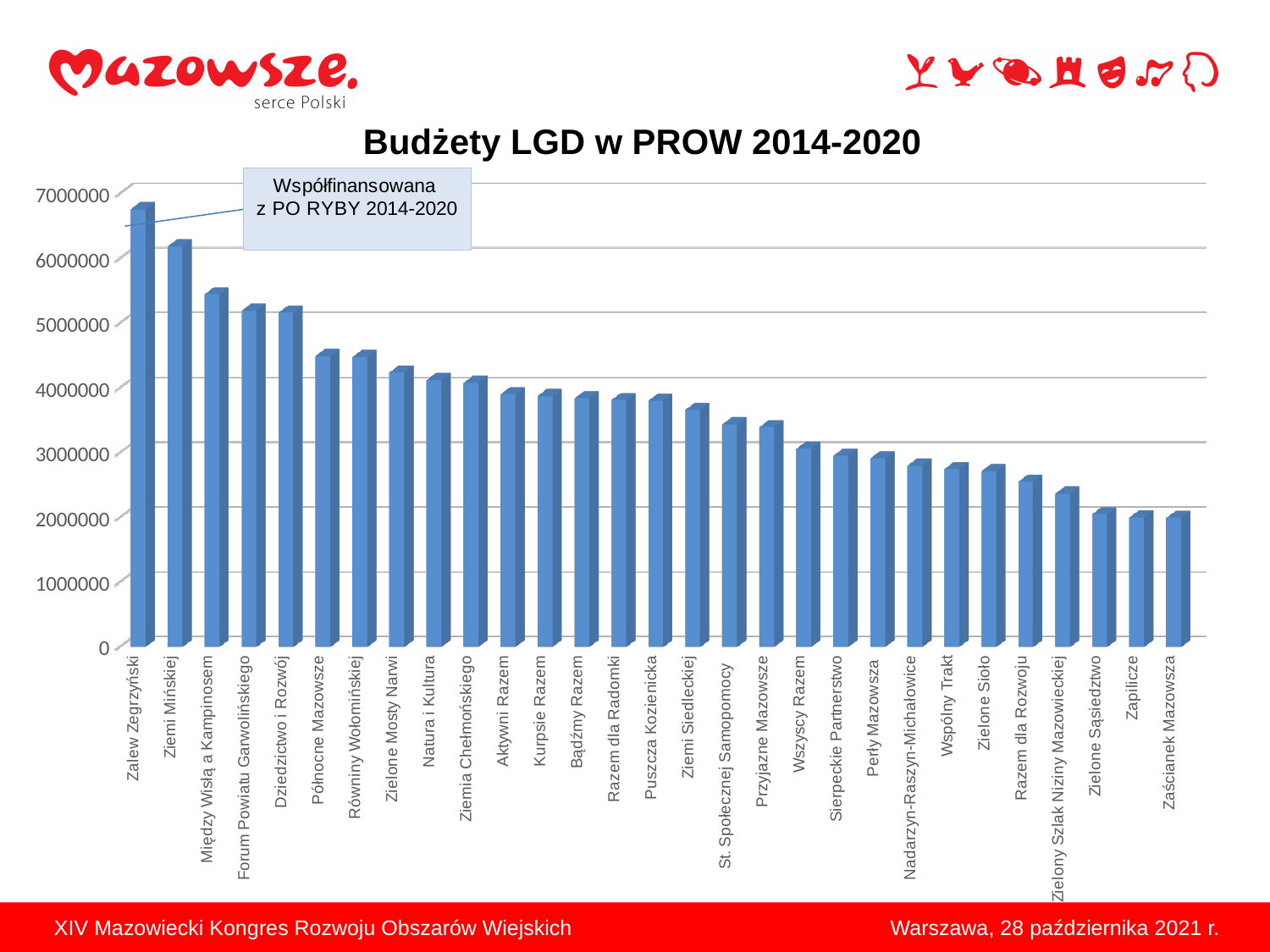
Is the value for Północne Mazowsze greater or less than 4000000? greater Is the value for Między Wisłą a Kampinosem greater or less than 5000000? greater Is the value for Przyjazne Mazowsze greater or less than 4000000? less How many LGD categories are plotted on the x axis? 29 Do the values rise or fall moving from left to right along the x axis? fall What kind of chart is shown on the slide? bar chart What is the title of the chart? Budżety LGD w PROW 2014-2020 Which has the larger budget, Zalew Zegrzyński or Ziemi Mińskiej? Zalew Zegrzyński Which LGD has the highest budget in the chart? Zalew Zegrzyński Which LGD does the annotation 'Współfinansowana z PO RYBY 2014-2020' point to? Zalew Zegrzyński